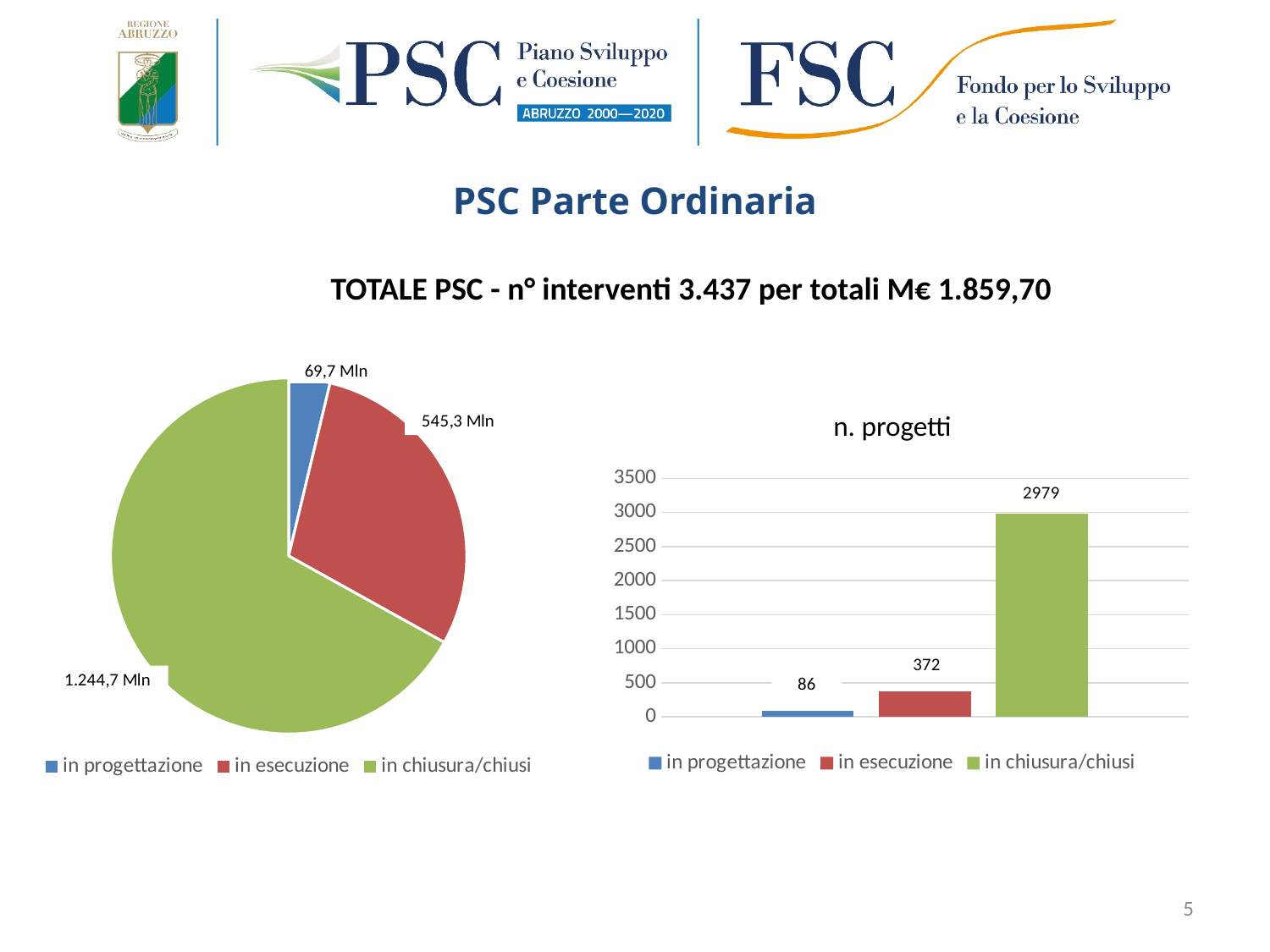
In the pie chart on the left, what is the value labelled for the "in esecuzione" slice? 545,3 Mln In the pie chart on the left, what is the value labelled for the "in chiusura/chiusi" slice? 1.244,7 Mln In the bar chart titled "n. progetti", what is the value for "in esecuzione"? 372 In the bar chart titled "n. progetti", which category has the lowest value? in progettazione What kind of chart is the chart on the right of the slide? bar chart In the bar chart titled "n. progetti", which category has the highest value? in chiusura/chiusi In the bar chart titled "n. progetti", how many categories are plotted? 3 In the bar chart titled "n. progetti", what is the value for "in chiusura/chiusi"? 2979 In the pie chart on the left, which is larger: the "in esecuzione" slice or the "in progettazione" slice? in esecuzione In the bar chart titled "n. progetti", what is the difference between the values for "in chiusura/chiusi" and "in esecuzione"? 2607 In the pie chart on the left, which slice is the smallest? in progettazione In the bar chart titled "n. progetti", what is the value for "in progettazione"? 86